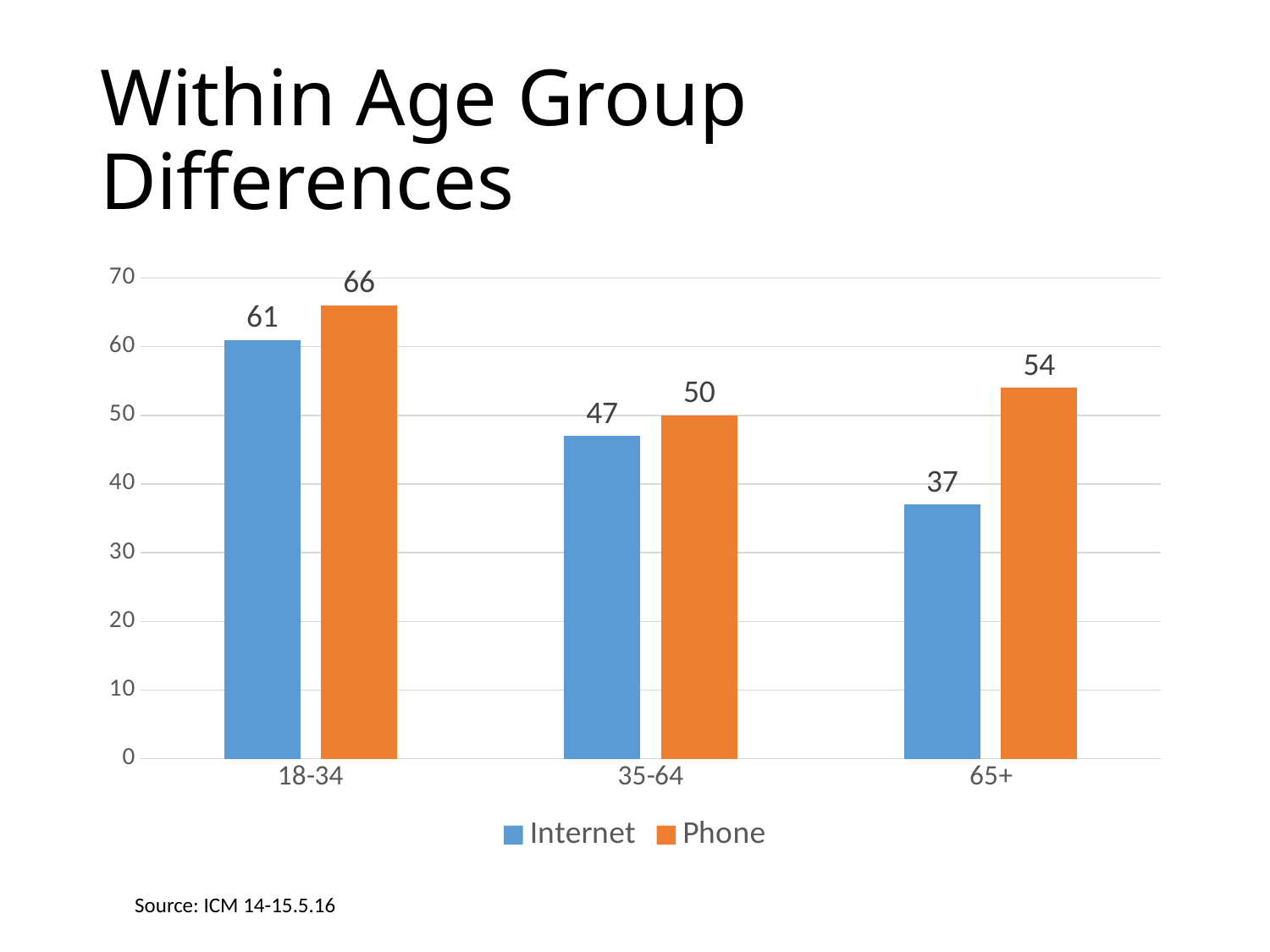
Which is larger for the 35-64 age group, Internet or Phone? Phone Which age group has the lowest Phone value? 35-64 What is the Phone value for the 65+ age group? 54 How many age groups are shown on the x axis? 3 What is the Phone value for the 35-64 age group? 50 What is the Internet value for the 18-34 age group? 61 What is the difference between the Internet values for 18-34 and 65+? 24 What kind of chart is shown on the slide? Bar chart Which age group has the highest Internet value? 18-34 What is the difference between the Phone and Internet values for the 65+ age group? 17 Do the Internet values rise or fall from 18-34 to 65+? Fall How many series does the legend list? 2